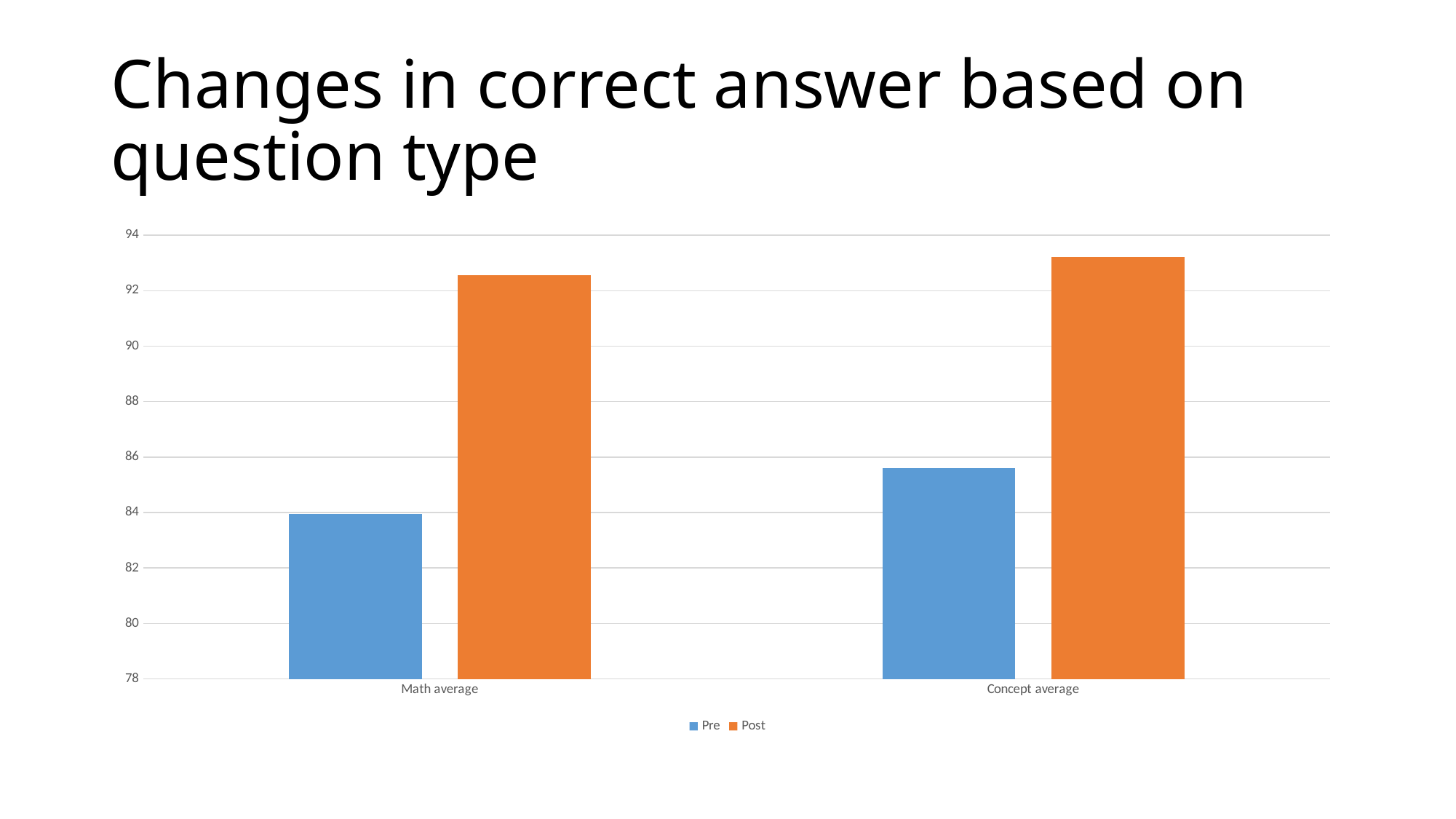
Which bar is the highest on the chart? Post for Concept average How many series does the legend list? 2 Is the Post value for Math average greater or less than 90? greater Is the Post value for Concept average greater or less than 92? greater Is the Pre value for Math average greater or less than 86? less Which bar is the lowest on the chart? Pre for Math average How many categories are shown on the x axis? 2 What kind of chart is shown on the slide? bar chart Which category has the higher Pre value? Concept average Which series is shown in orange? Post For Math average, which is larger, the Pre value or the Post value? Post